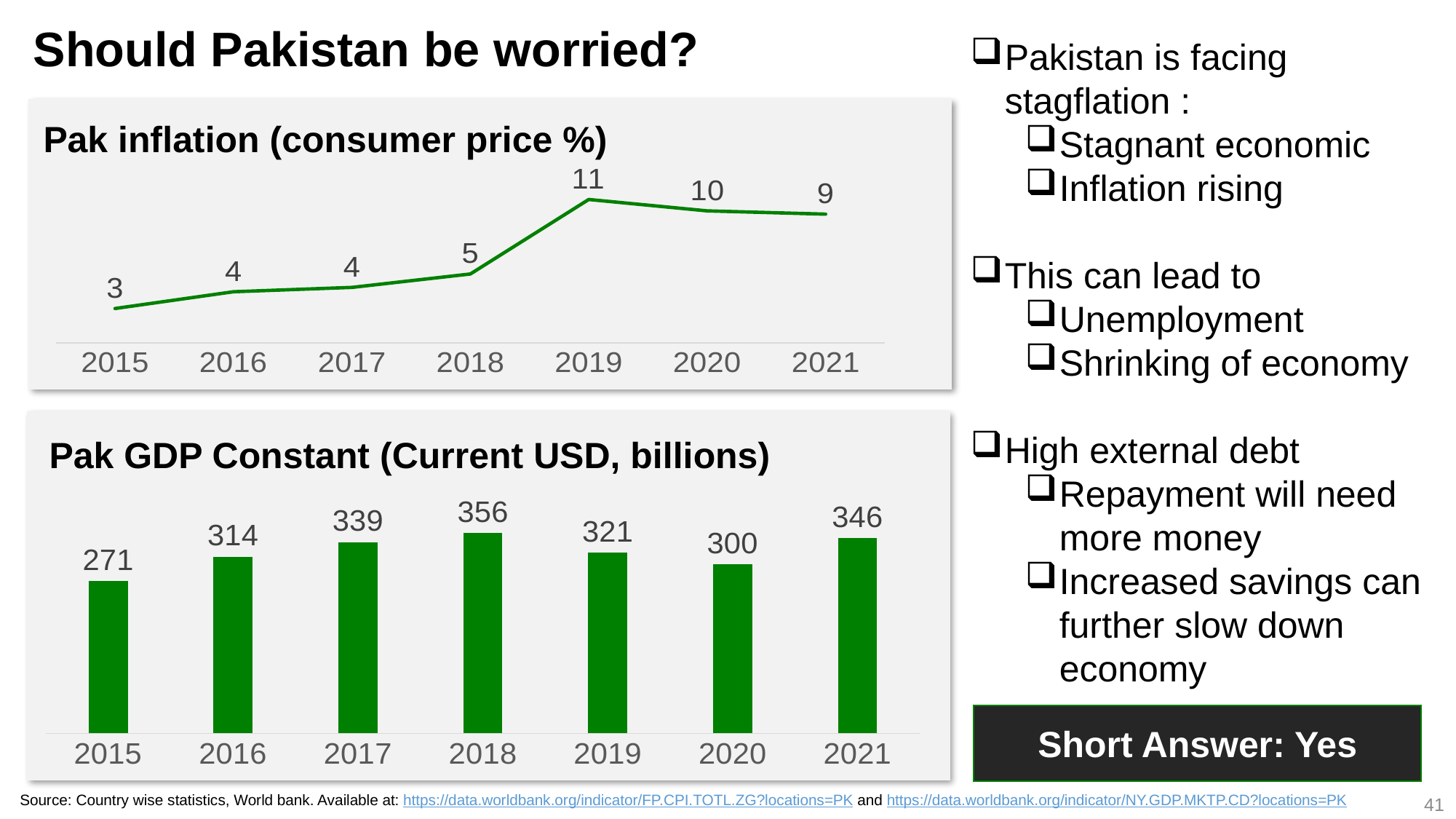
What kind of chart is the 'Pak GDP Constant (Current USD, billions)' chart? Bar chart In the 'Pak GDP Constant (Current USD, billions)' chart, which is larger, the value for 2017 or the value for 2019? 2017 In the 'Pak GDP Constant (Current USD, billions)' chart, which year has the highest GDP? 2018 In the 'Pak GDP Constant (Current USD, billions)' chart, what is the value for 2020? 300 What kind of chart is the 'Pak inflation (consumer price %)' chart? Line chart How many years are plotted in the 'Pak inflation (consumer price %)' chart? 7 In the 'Pak GDP Constant (Current USD, billions)' chart, what is the difference between the 2021 and 2020 values? 46 In the 'Pak GDP Constant (Current USD, billions)' chart, which year has the lowest GDP? 2015 In the 'Pak inflation (consumer price %)' chart, what is the value for 2019? 11 In the 'Pak inflation (consumer price %)' chart, do the values rise or fall from 2015 to 2019? Rise In the 'Pak inflation (consumer price %)' chart, which year has the lowest inflation? 2015 In the 'Pak inflation (consumer price %)' chart, what is the difference between the 2019 and 2018 values? 6